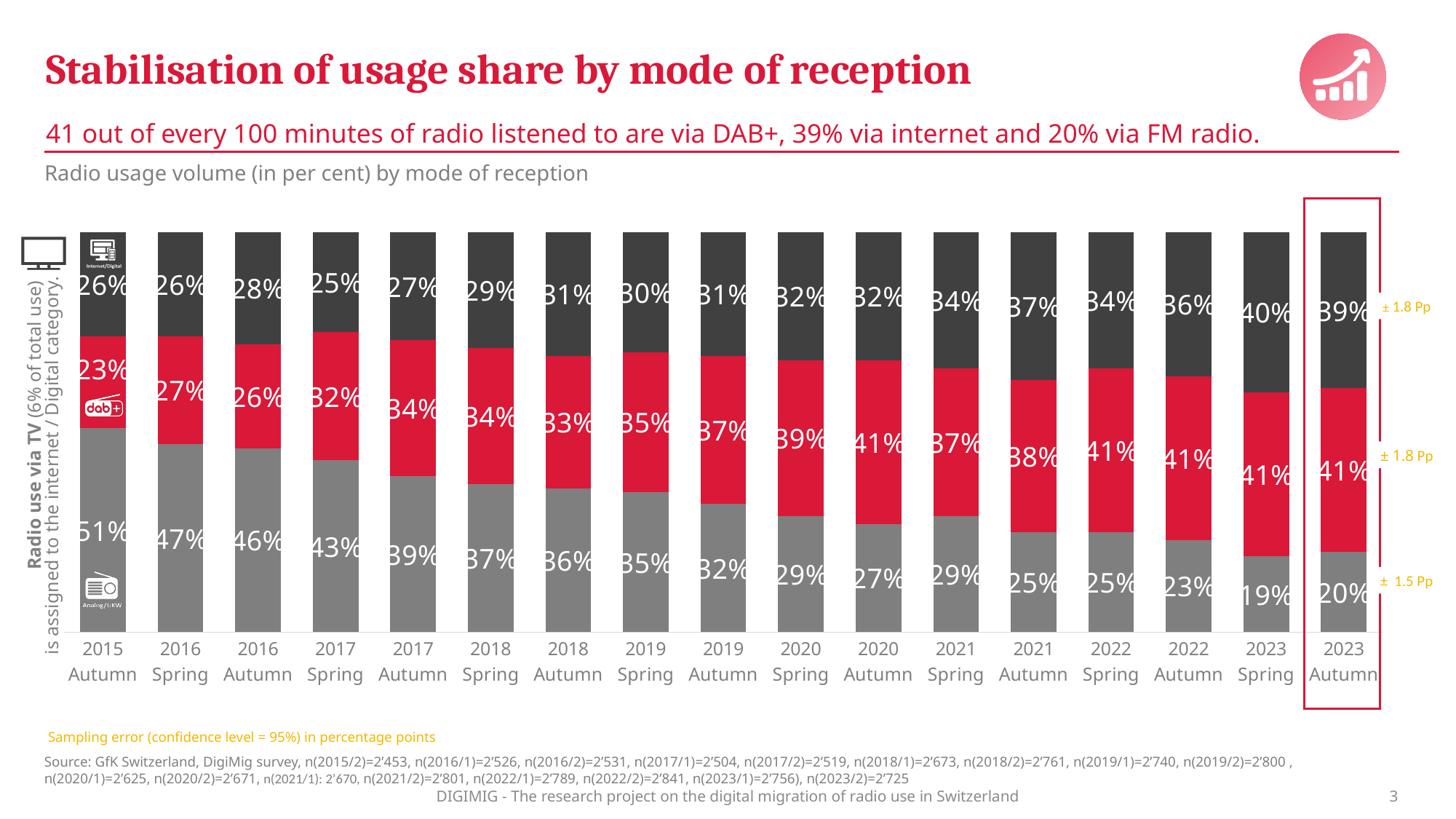
What is the FM (Analog/UKW) share in 2015 Autumn? 51% What is the Internet/Digital share in 2023 Spring? 40% How many time periods (bars) are shown on the x axis? 17 What kind of chart is shown on the slide? Stacked bar chart Does the FM (Analog/UKW) share rise or fall from 2015 Autumn to 2023 Autumn? Fall In which period is the FM (Analog/UKW) share highest? 2015 Autumn What is the DAB+ share in 2017 Spring? 32% What is the sampling error shown for the DAB+ segment in 2023 Autumn? ± 1.8 Pp What is the difference between the FM share in 2015 Autumn and in 2023 Autumn? 31 percentage points What is the DAB+ share in 2023 Autumn? 41% In which period is the FM (Analog/UKW) share lowest? 2023 Spring Which is larger in 2023 Autumn: the DAB+ share or the Internet/Digital share? DAB+